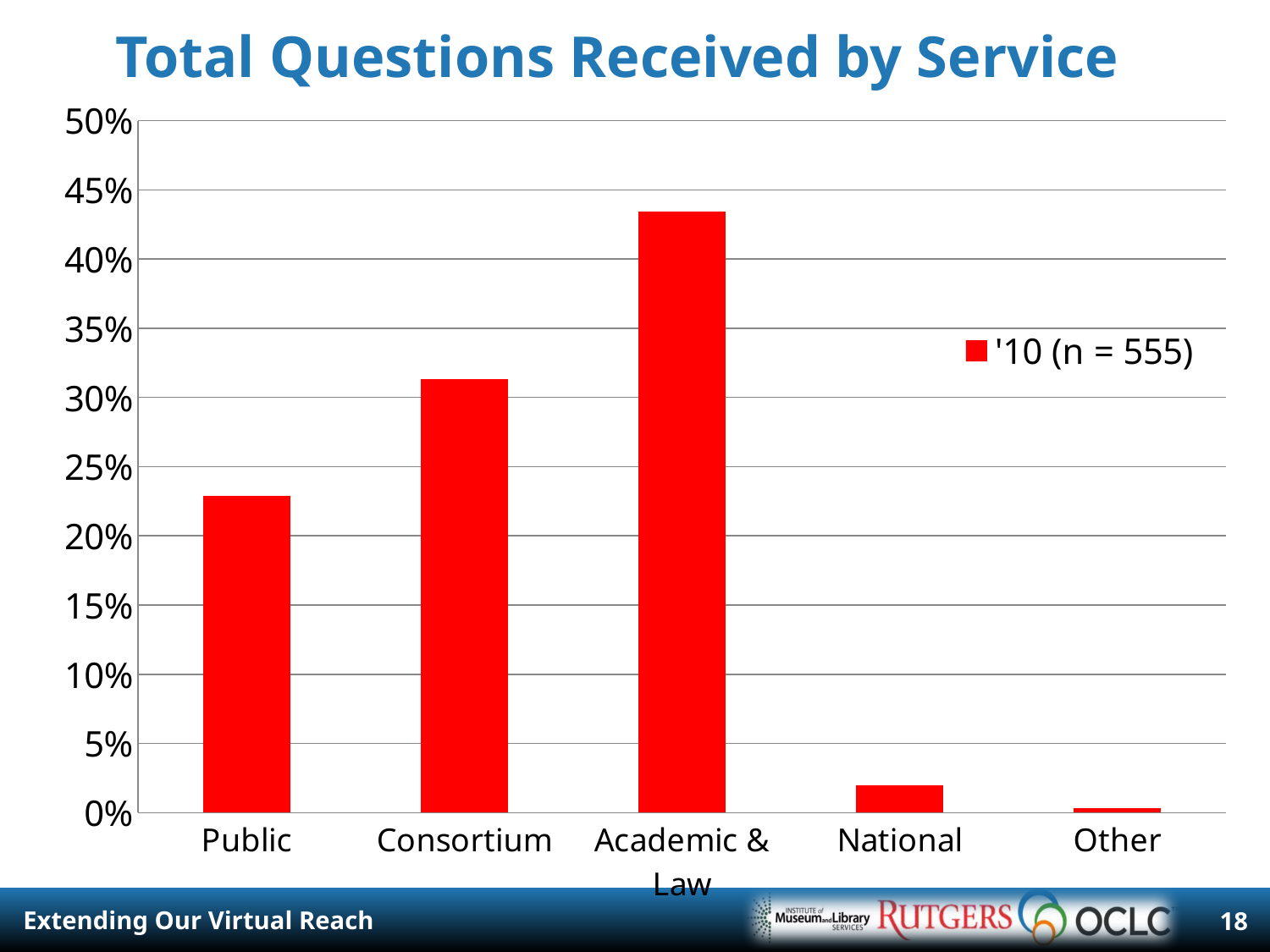
What is the legend entry for the series? '10 (n = 555) How many categories are shown on the x axis? 5 Is the value for Public greater or less than 25%? less Is the value for National greater or less than 5%? less What kind of chart is shown on the slide? bar chart Which category has the highest value? Academic & Law How many series does the legend list? 1 Which is larger, the value for Consortium or the value for Public? Consortium Which category has the lowest value? Other Is the value for Academic & Law greater or less than 40%? greater What is the title of the chart? Total Questions Received by Service